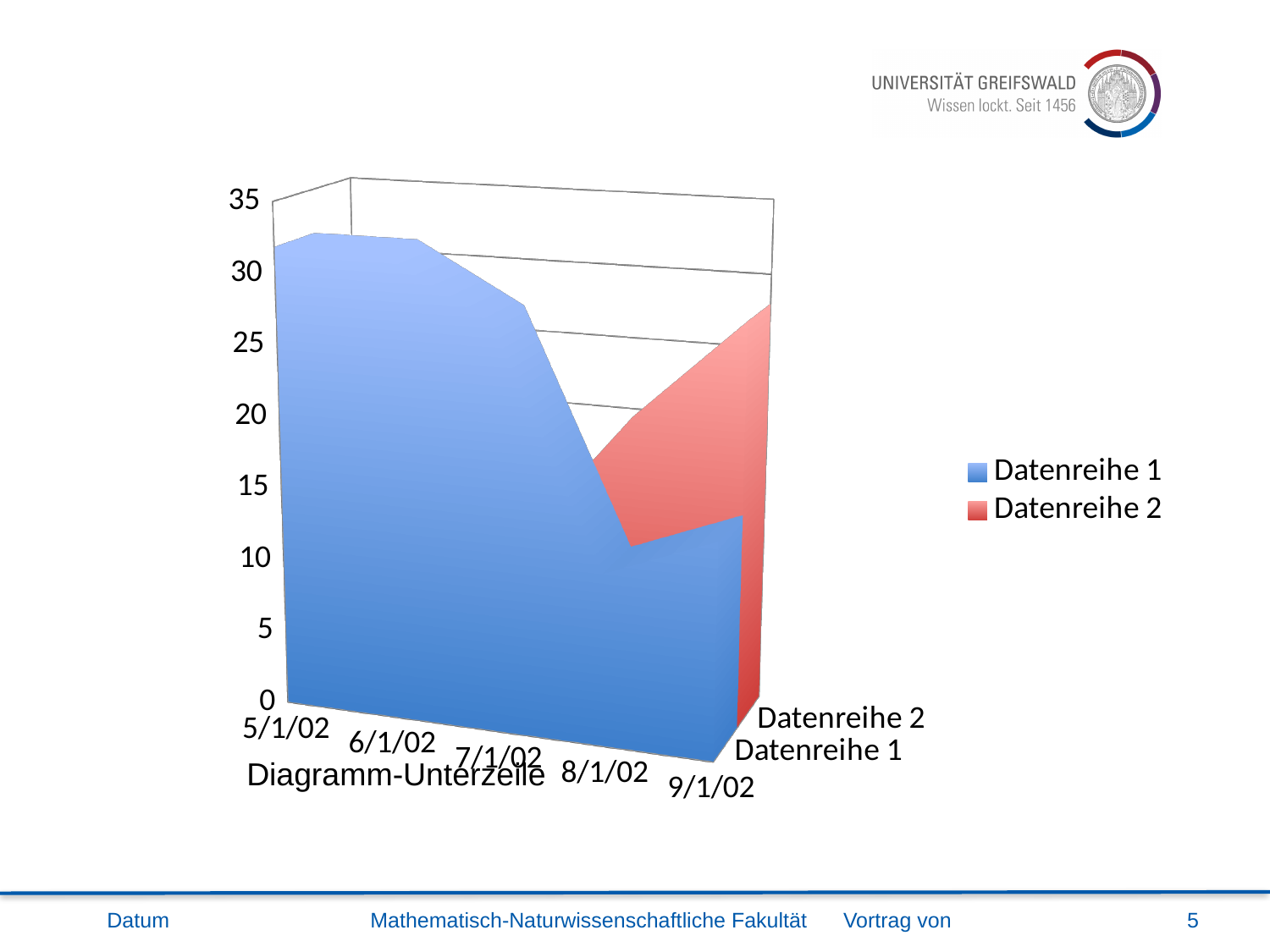
How many dates are shown on the x axis? 5 How many series does the legend list? 2 What text appears below the x axis as the chart subtitle? Diagramm-Unterzeile Is the value for Datenreihe 1 at 5/1/02 greater or less than 25? greater Is the value for Datenreihe 1 at 9/1/02 greater or less than 20? less At 9/1/02, which series has the larger value, Datenreihe 1 or Datenreihe 2? Datenreihe 2 Is the value for Datenreihe 1 at 8/1/02 greater or less than 20? less Which is larger for Datenreihe 1: the value at 5/1/02 or the value at 8/1/02? 5/1/02 Does Datenreihe 1 rise or fall from 5/1/02 to 8/1/02? fall Which series is shown in blue? Datenreihe 1 What kind of chart is shown on the slide? Area chart